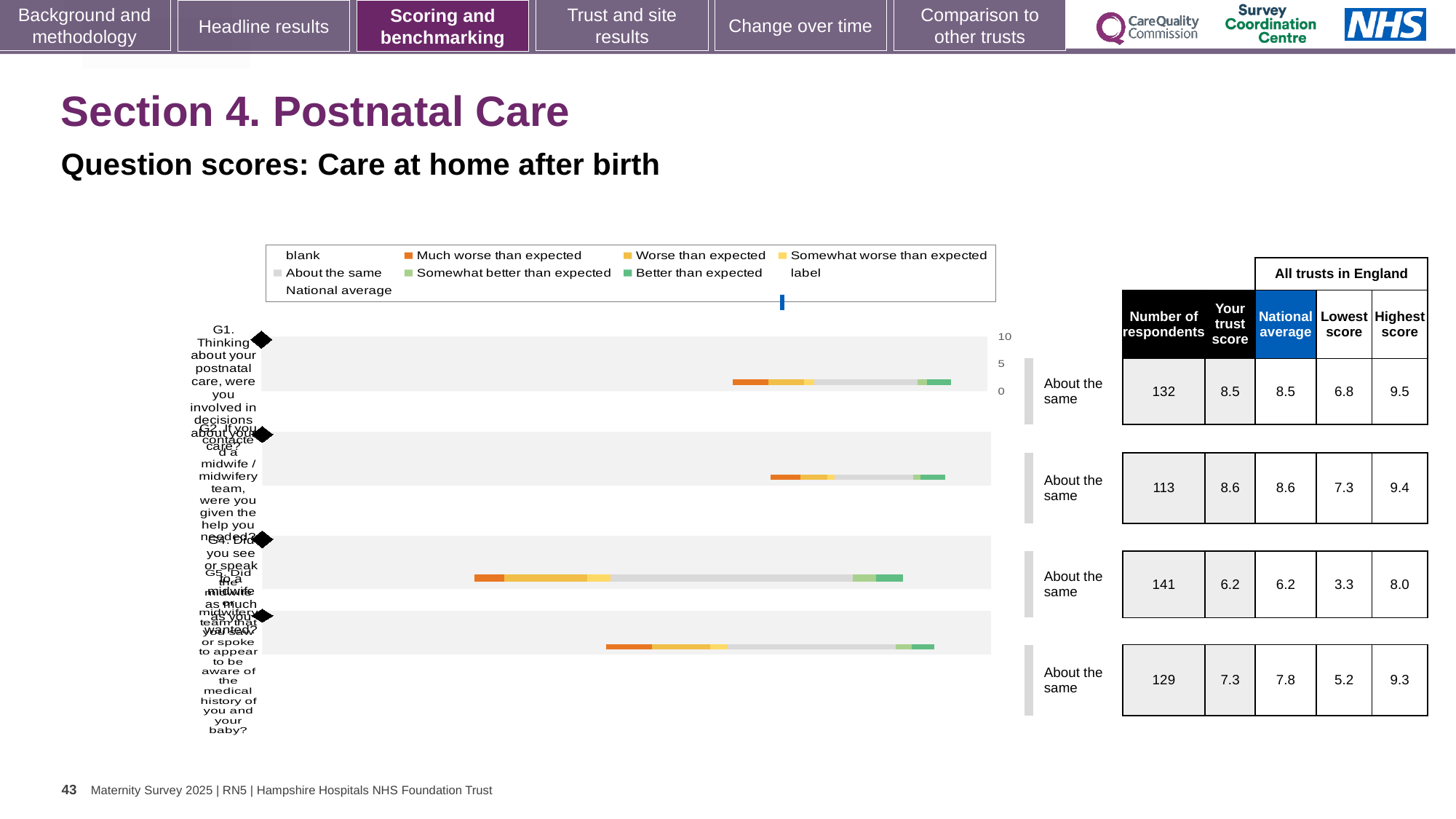
In the table beside the chart, which row has the highest number of respondents? G4 (third row), 141 How many question rows (categories) are plotted in the chart? 4 Which legend entry is shown in orange in the chart? Much worse than expected In the table beside the chart, what is the difference between the highest score and lowest score for the G4 row (third row)? 4.7 In the table beside the chart, is the trust score for the G5 row (fourth row) larger or smaller than its national average? smaller In the table beside the chart, what is the number of respondents for the G1 row (first row)? 132 What benchmark label is shown next to each of the four chart rows? About the same What is the highest value shown on the chart's score axis? 10 What kind of chart is shown on the slide? bar chart In the table beside the chart, which row has the lowest 'Your trust score'? G4 (third row), 6.2 In the table beside the chart, what is the national average for the G5 row (fourth row)? 7.8 In the table beside the chart, what is the trust score for the G2 row (second row)? 8.6